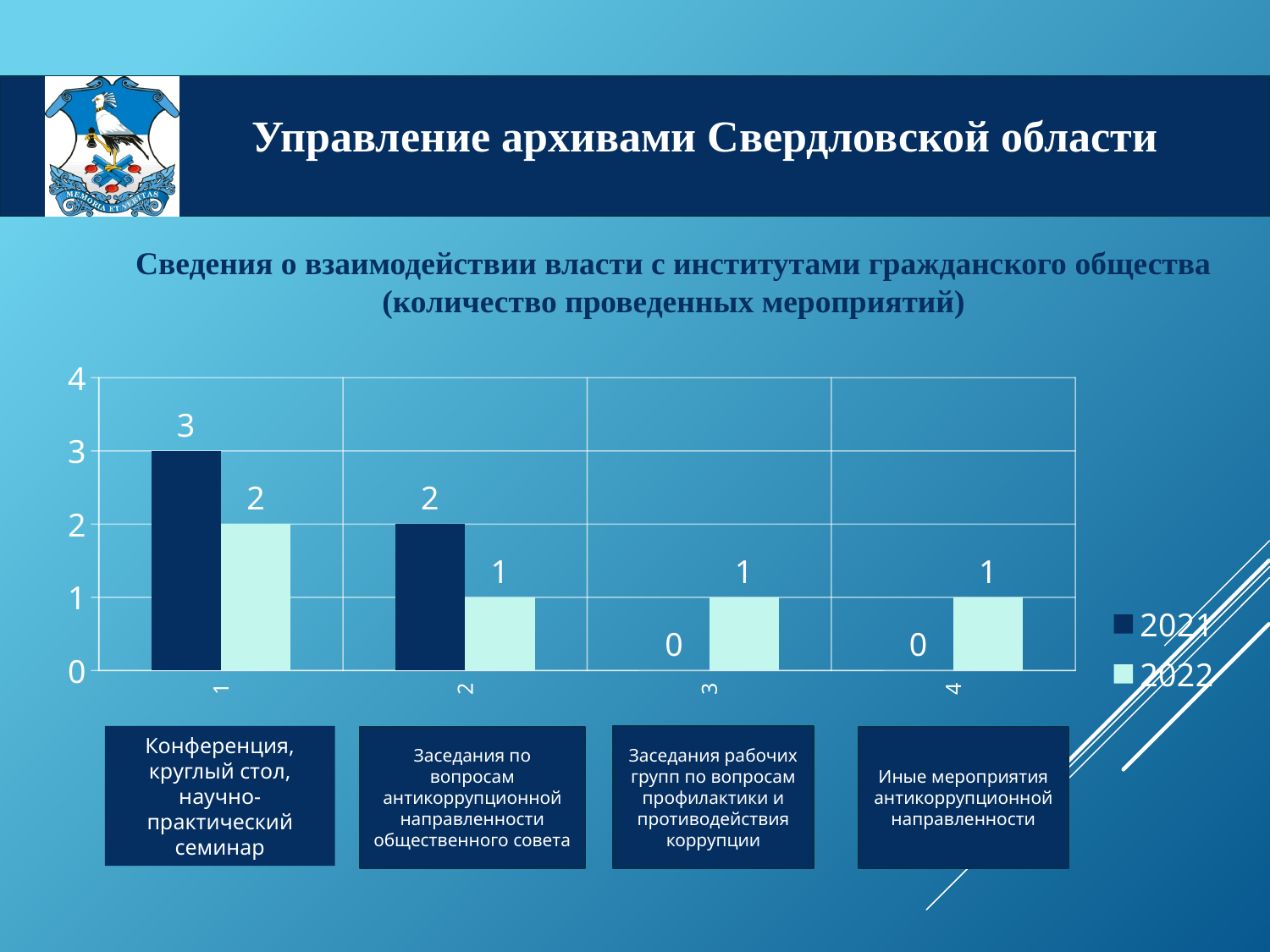
How many series does the legend list? 2 How many categories are shown on the x axis? 4 What is the 2022 value for category 4 (Иные мероприятия антикоррупционной направленности)? 1 Which category has the highest 2021 value? 1 (Конференция, круглый стол, научно-практический семинар) For category 3, which series has the larger value, 2021 or 2022? 2022 Which category has the highest 2022 value? 1 (Конференция, круглый стол, научно-практический семинар) What is the difference between the 2021 and 2022 values for category 1? 1 What is the 2021 value for category 3 (Заседания рабочих групп по вопросам профилактики и противодействия коррупции)? 0 What kind of chart is shown on the slide? Bar chart What is the 2021 value for category 1 (Конференция, круглый стол, научно-практический семинар)? 3 Which series is shown in dark blue in the legend? 2021 What is the 2022 value for category 2 (Заседания по вопросам антикоррупционной направленности общественного совета)? 1